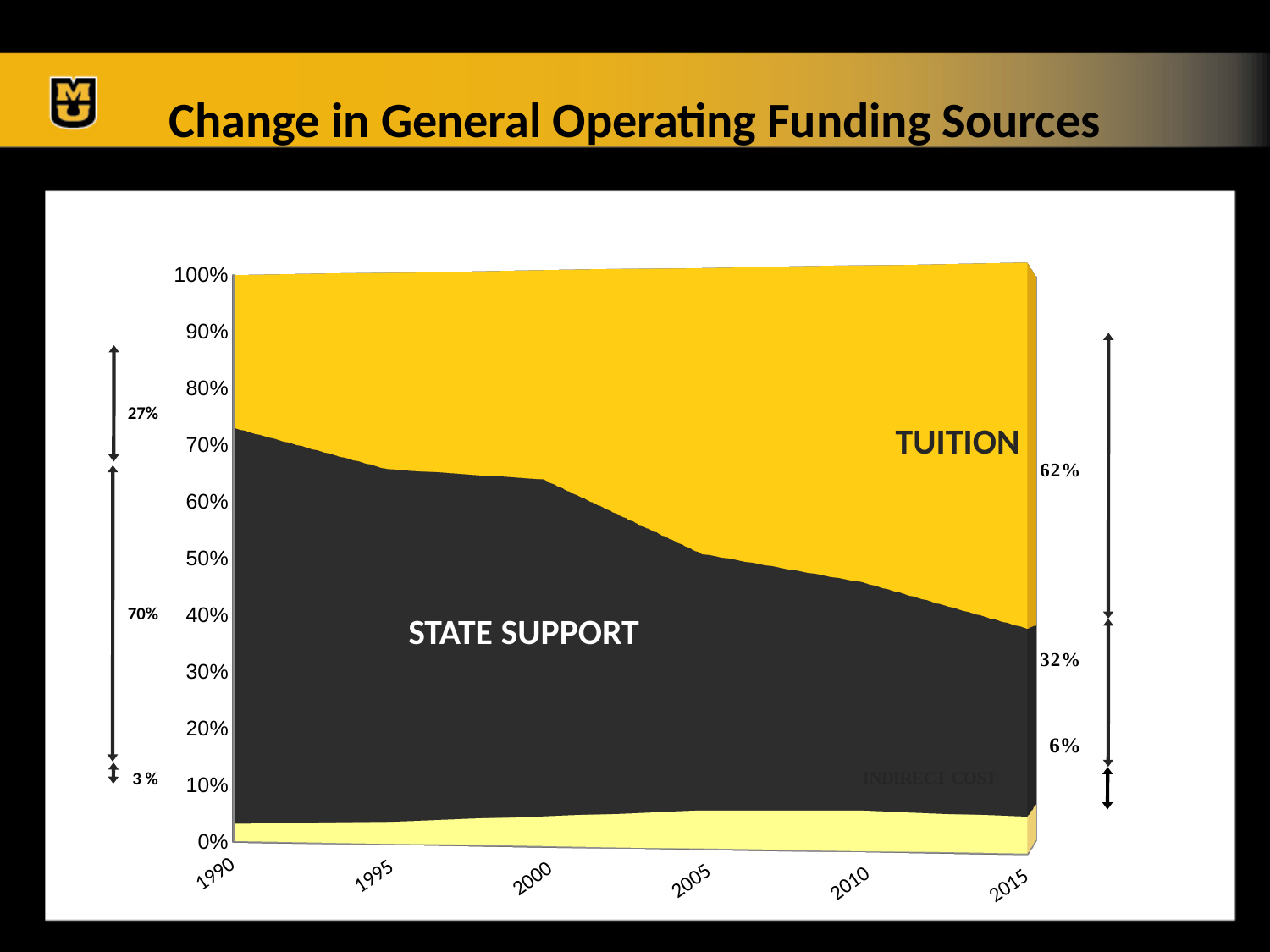
Which funding source had the larger share in 2015, tuition or state support? Tuition What share of general operating funding came from tuition in 2015? 62% Does the state support share rise or fall from 1990 to 2015? fall What kind of chart is shown on the slide? area chart By how many percentage points did the state support share fall between 1990 and 2015? 38 percentage points What share of general operating funding came from state support in 2015? 32% What share of general operating funding came from indirect cost in 1990? 3% What share of general operating funding came from tuition in 1990? 27% What share of general operating funding came from state support in 1990? 70% By how many percentage points did the tuition share rise between 1990 and 2015? 35 percentage points How many funding sources are plotted in the chart? 3 What share of general operating funding came from indirect cost in 2015? 6%